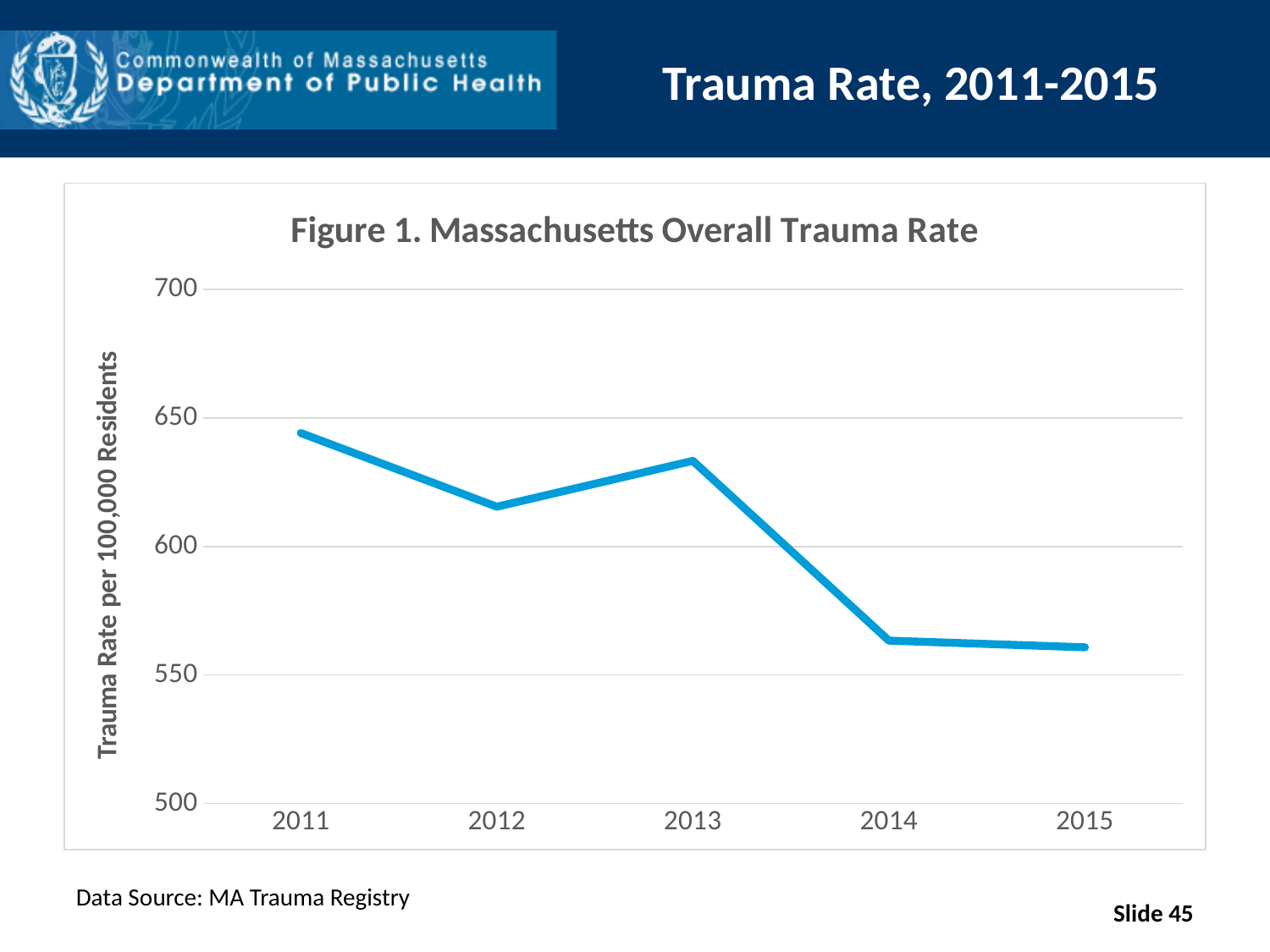
Which year has the larger trauma rate, 2011 or 2014? 2011 What kind of chart is shown on the slide? line chart How many years are plotted on the x axis of the chart? 5 Does the trauma rate rise or fall between 2013 and 2014? fall Overall, does the trauma rate rise or fall from 2011 to 2015? fall Is the trauma rate for 2014 greater or less than 600? less Which year has the highest trauma rate in the chart? 2011 Is the trauma rate for 2015 greater or less than 550? greater Which year has the larger trauma rate, 2012 or 2013? 2013 Is the trauma rate for 2013 greater or less than 650? less What is the title of the chart? Figure 1. Massachusetts Overall Trauma Rate